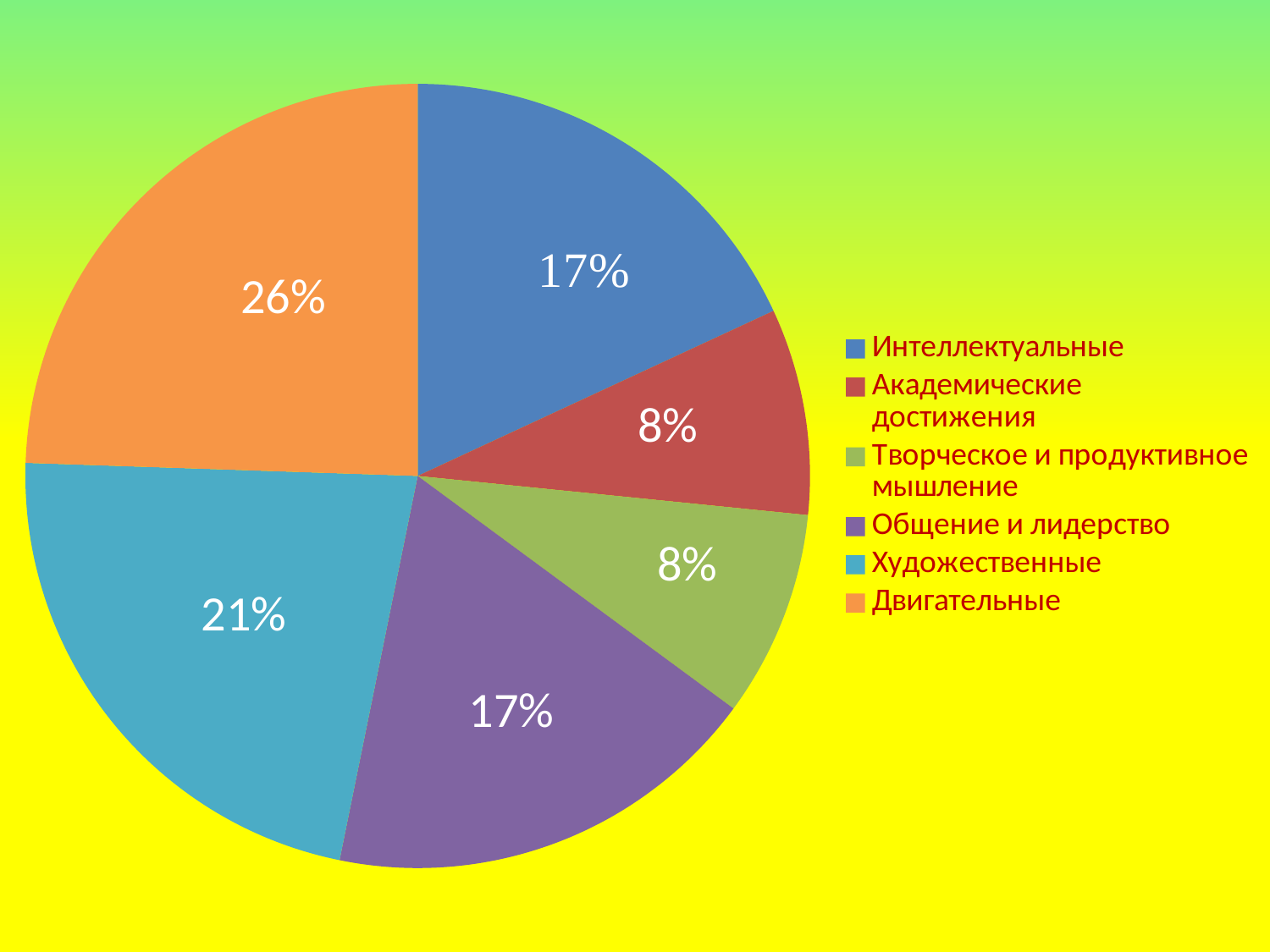
What share of the pie does Двигательные have? 26% What share of the pie does Академические достижения have? 8% What share of the pie does Интеллектуальные have? 17% What colour is the slice for Художественные? light blue How many categories does the pie chart have? 6 Which is larger, the share of Художественные or the share of Общение и лидерство? Художественные Which category has the largest slice of the pie? Двигательные What is the difference between the shares of Двигательные and Художественные? 5% What kind of chart is shown on the slide? pie chart